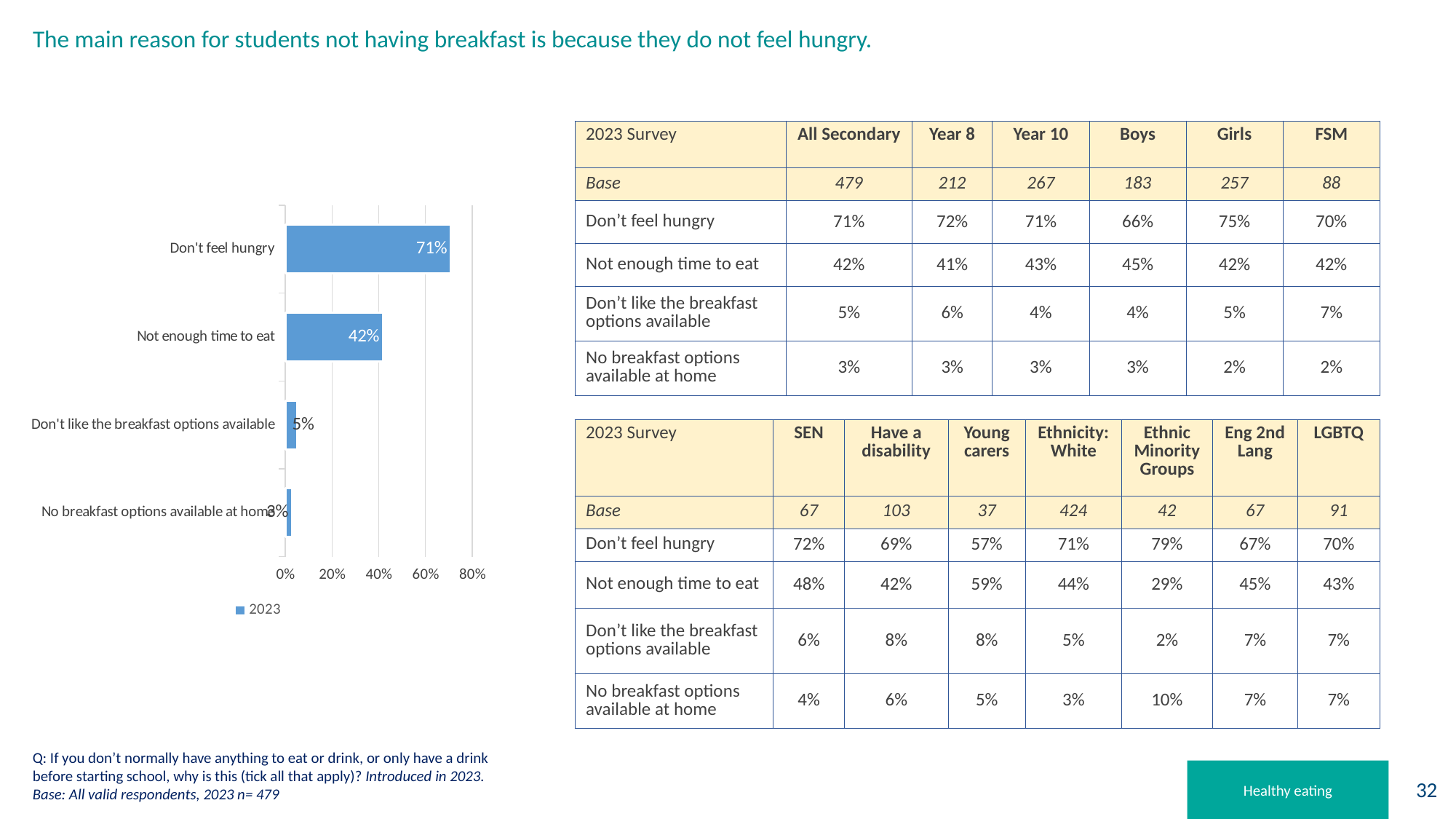
Which category has the lowest value in the bar chart? No breakfast options available at home What series does the legend of the bar chart list? 2023 Is the value for "Not enough time to eat" in the bar chart greater or less than 60%? less What is the value for "Not enough time to eat" in the bar chart? 42% What is the value for "No breakfast options available at home" in the bar chart? 3% Which category has the highest value in the bar chart? Don't feel hungry What kind of chart is shown on the slide? Bar chart What is the value for "Don't like the breakfast options available" in the bar chart? 5% Which is larger in the bar chart: "Don't like the breakfast options available" or "No breakfast options available at home"? Don't like the breakfast options available What is the value for "Don't feel hungry" in the bar chart? 71% How many categories are shown in the bar chart? 4 What is the difference between the values for "Don't feel hungry" and "Not enough time to eat" in the bar chart? 29%